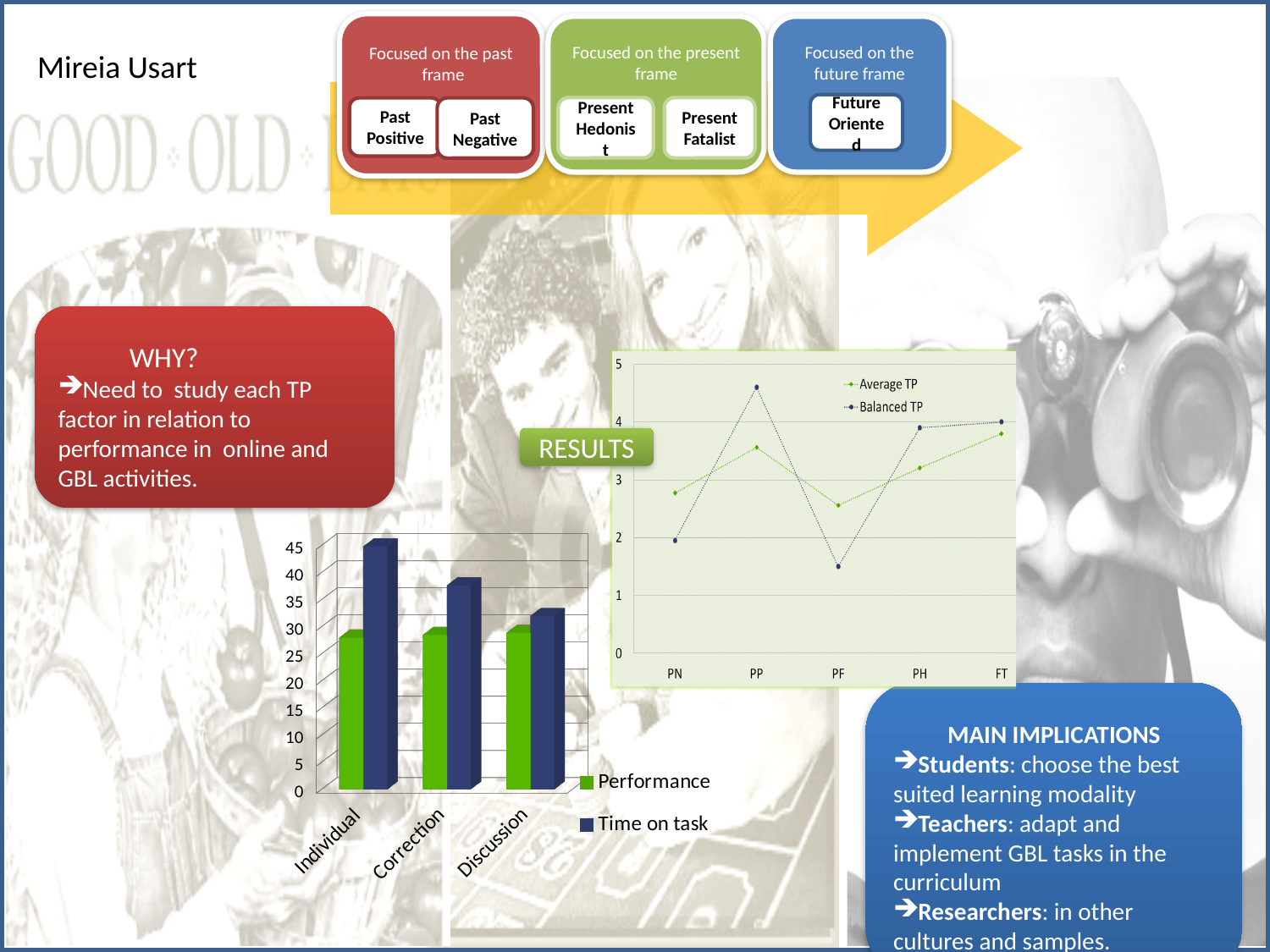
In the line chart on the right, is the Balanced TP value for PP greater or less than 4? greater In the line chart on the right, which category has the lowest Balanced TP value? PF In the bar chart at the bottom left, for Individual, which series has the larger value: Performance or Time on task? Time on task What kind of chart is the chart at the bottom left of the slide? bar chart In the bar chart at the bottom left, how many series does the legend list? 2 What kind of chart is the chart on the right with categories PN, PP, PF, PH and FT? line chart In the bar chart at the bottom left, which category has the lowest Time on task value? Discussion In the line chart on the right, which category has the highest Balanced TP value? PP In the bar chart at the bottom left, which category has the highest Time on task value? Individual In the line chart on the right, how many categories are shown on the x axis? 5 In the bar chart at the bottom left, how many categories are shown on the x axis? 3 In the bar chart at the bottom left, is the Time on task value for Individual greater or less than 35? greater